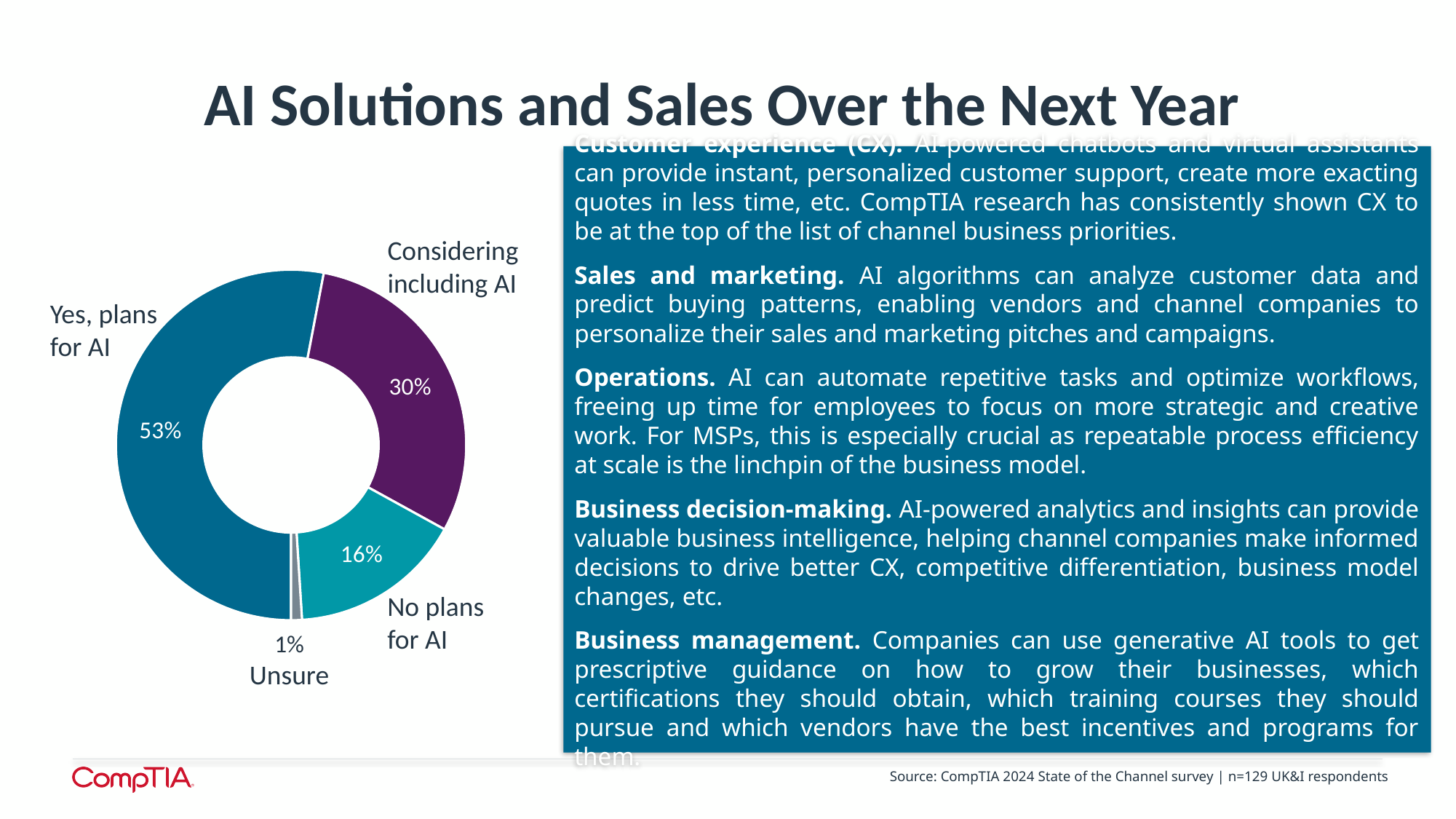
What is the combined share of 'Yes, plans for AI' and 'Considering including AI'? 83% How many categories are shown in the chart? 4 What percentage of respondents are 'Considering including AI'? 30% Which category has the largest share of the chart? Yes, plans for AI Which is larger: 'Considering including AI' or 'No plans for AI'? Considering including AI Which category has the smallest share of the chart? Unsure What percentage of respondents are 'Unsure'? 1% What percentage of respondents said 'Yes, plans for AI'? 53% What colour is the 'No plans for AI' slice? Teal What percentage of respondents have 'No plans for AI'? 16% What kind of chart is shown on the slide? Donut (pie) chart What is the difference in percentage points between 'Yes, plans for AI' and 'Considering including AI'? 23